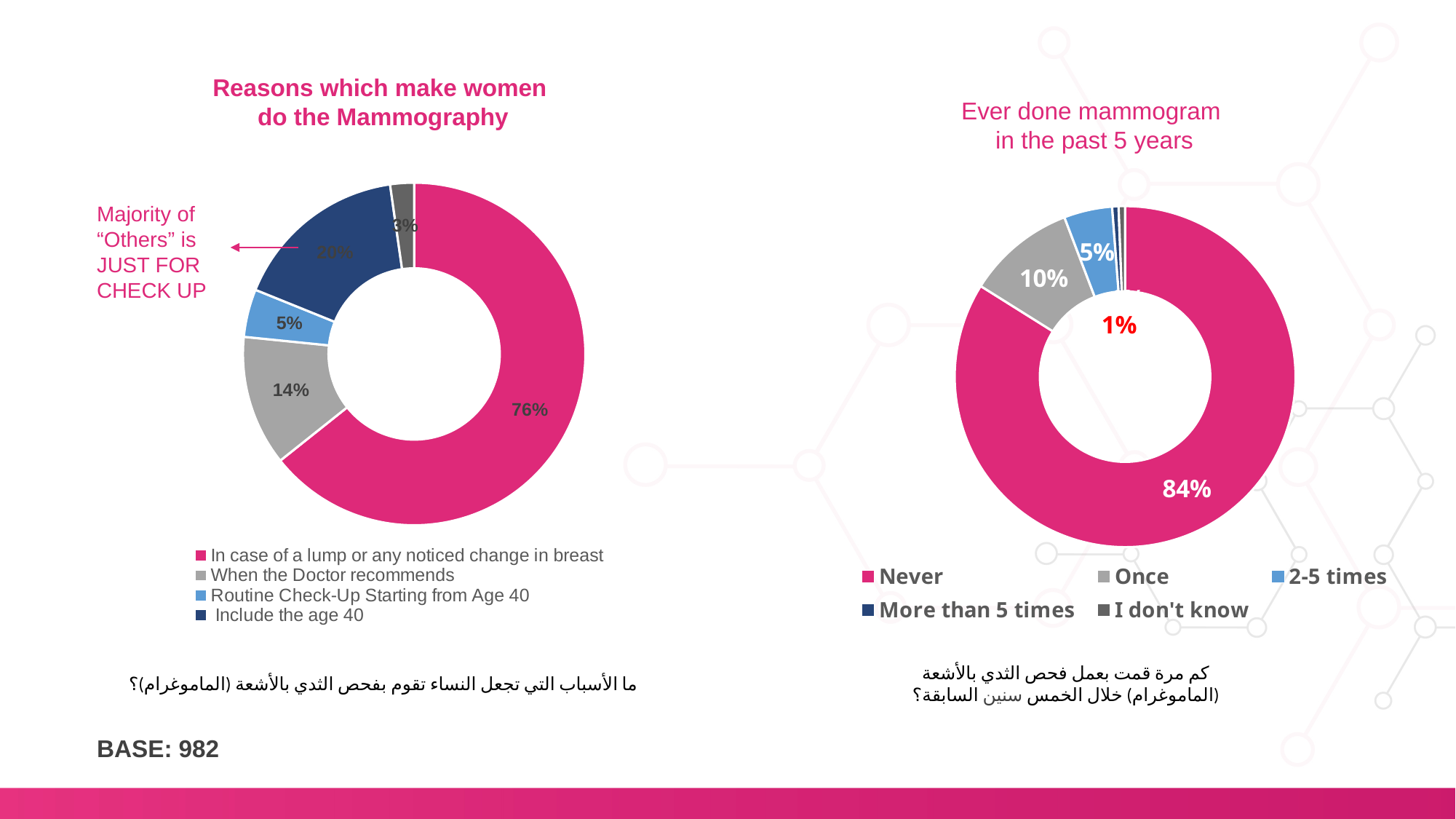
In the chart titled "Reasons which make women do the Mammography", what percentage is shown for "In case of a lump or any noticed change in breast"? 76% In the chart titled "Reasons which make women do the Mammography", what percentage is shown for "Routine Check-Up Starting from Age 40"? 5% In the chart titled "Ever done mammogram in the past 5 years", what percentage of women answered "Never"? 84% In the chart titled "Ever done mammogram in the past 5 years", what percentage answered "2-5 times"? 5% In the chart titled "Ever done mammogram in the past 5 years", how many entries does the legend list? 5 In the chart titled "Ever done mammogram in the past 5 years", what is the difference between the "Never" and "Once" shares? 74% In the chart titled "Reasons which make women do the Mammography", which is larger: "When the Doctor recommends" or "Include the age 40"? Include the age 40 What type of chart is used for "Reasons which make women do the Mammography"? Donut (pie) chart In the chart titled "Ever done mammogram in the past 5 years", which category has the largest share? Never In the chart titled "Reasons which make women do the Mammography", what percentage is shown for "When the Doctor recommends"? 14% In the chart titled "Reasons which make women do the Mammography", how many entries does the legend list? 4 In the chart titled "Ever done mammogram in the past 5 years", what percentage answered "Once"? 10%